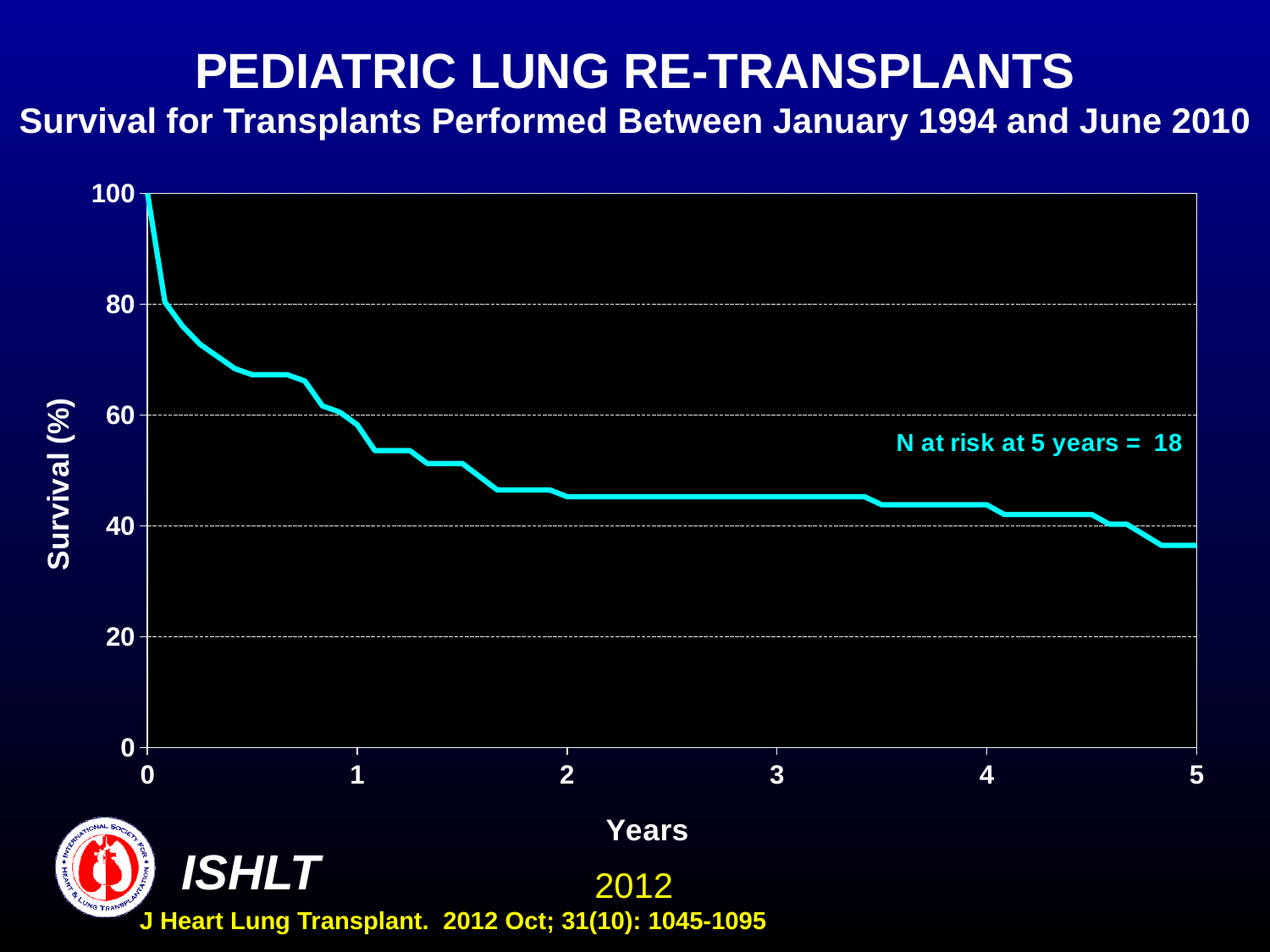
Is the survival value at 2 years greater or less than 40? greater What kind of chart is shown on the slide? line chart What is the N at risk at 5 years? 18 What is the label of the y axis? Survival (%) Is the survival value at 0.5 years greater or less than 80? less Does the survival curve rise or fall as years increase? fall Is the survival value at 3 years greater or less than 40? greater What is the survival (%) at year 0? 100 What is the label of the x axis? Years